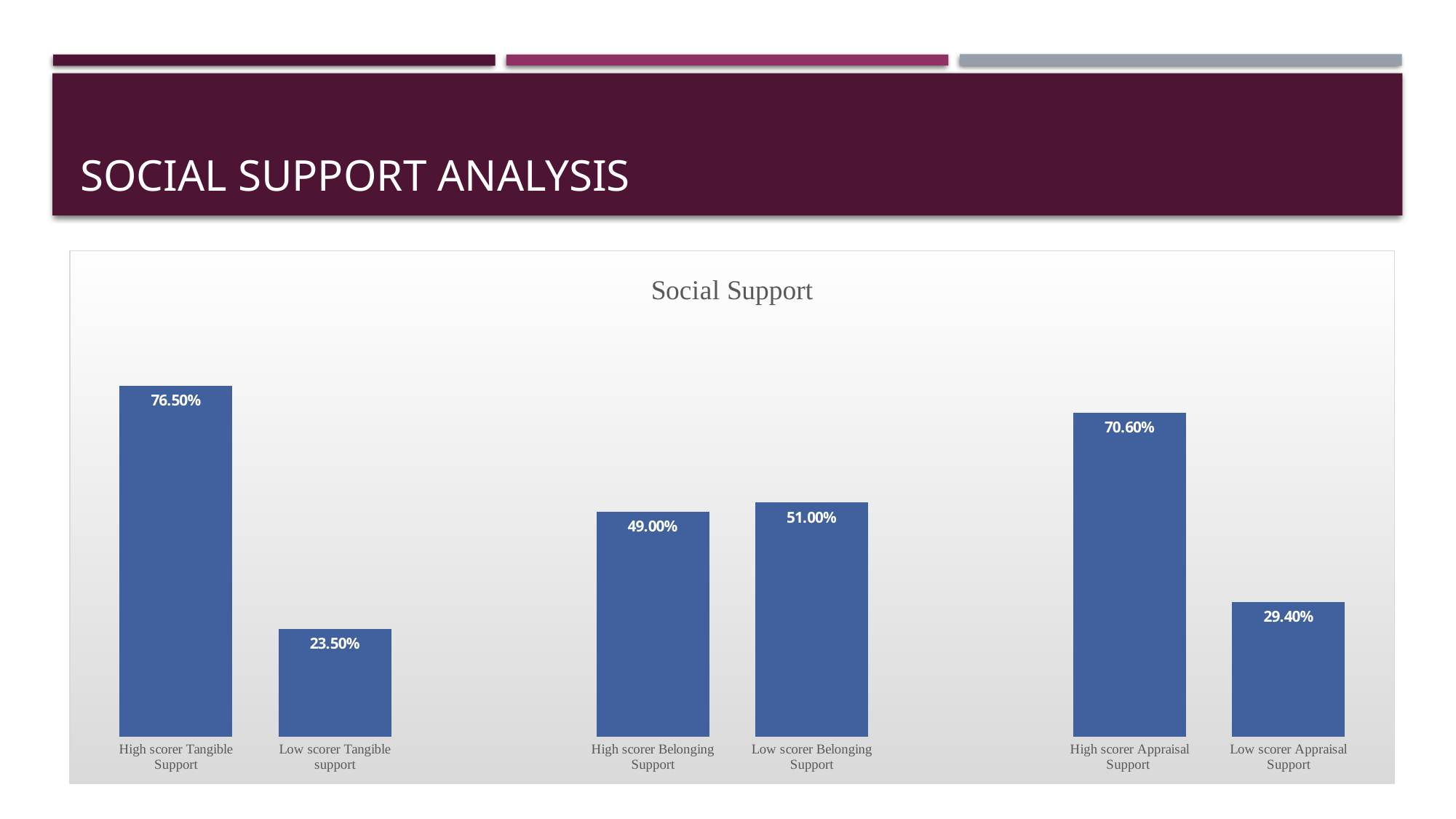
What is the value for High scorer Tangible Support? 76.50% What is the difference between Low scorer Belonging Support and High scorer Belonging Support? 2.00% What is the value for Low scorer Appraisal Support? 29.40% What is the difference between High scorer Appraisal Support and Low scorer Appraisal Support? 41.20% What is the title of the chart? Social Support Which category has the highest value? High scorer Tangible Support What is the value for Low scorer Tangible support? 23.50% What is the value for High scorer Belonging Support? 49.00% Which category has the lowest value? Low scorer Tangible support How many categories are shown in the chart? 6 Which is larger, High scorer Tangible Support or High scorer Appraisal Support? High scorer Tangible Support What kind of chart is shown on the slide? Bar chart